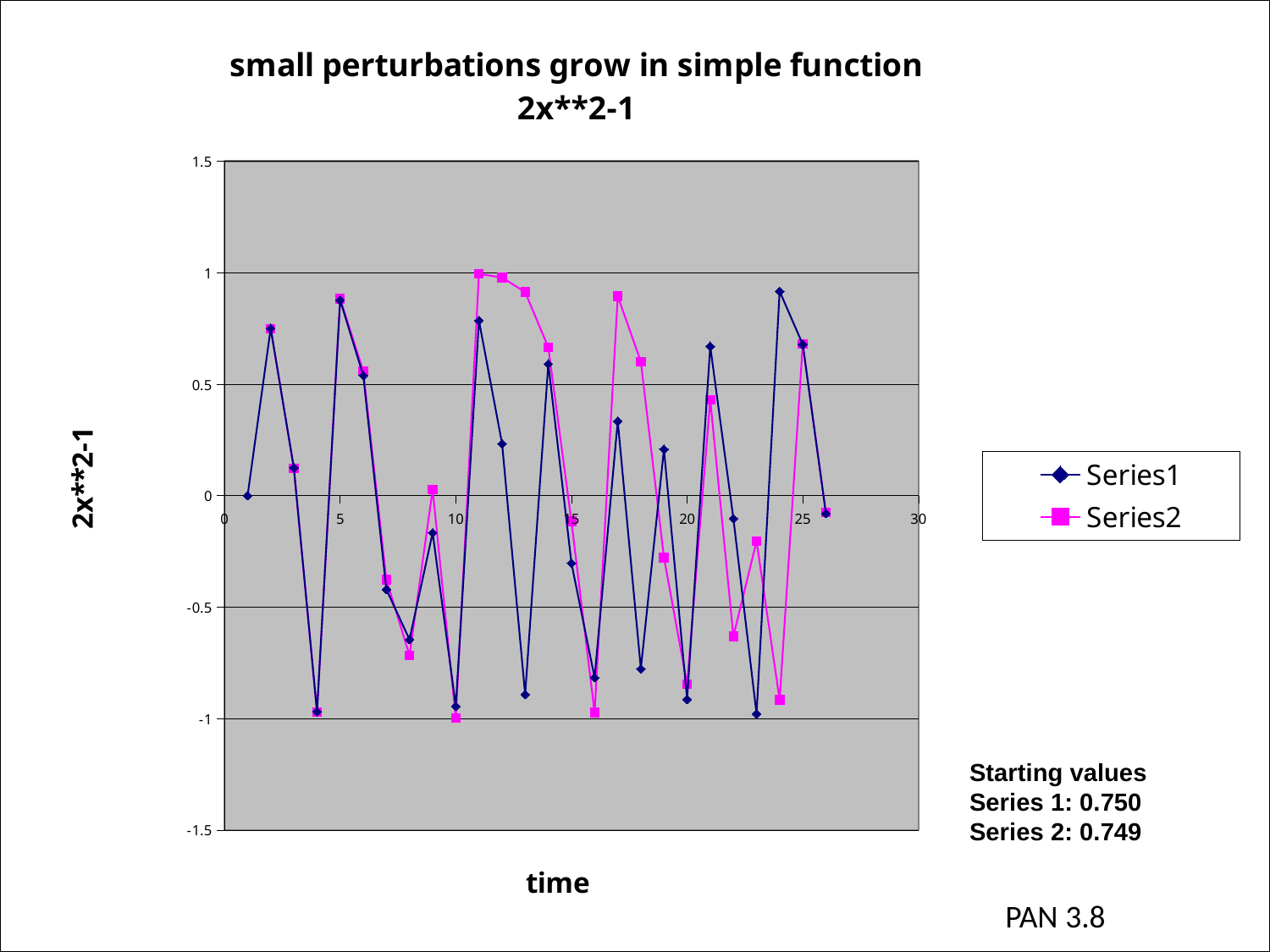
At time 17, which series has the larger value, Series1 or Series2? Series2 Is the value for Series2 at time 16 greater or less than -0.5? less What is the label on the x axis of the chart? time Is the value for Series2 at time 17 greater or less than 0.5? greater Is the value for Series1 at time 4 greater or less than -0.5? less At time 24, which series has the larger value, Series1 or Series2? Series1 What is the title of the chart? small perturbations grow in simple function 2x**2-1 How many series does the legend list? 2 At time 12, which series has the larger value, Series1 or Series2? Series2 What kind of chart is shown on the slide? line chart